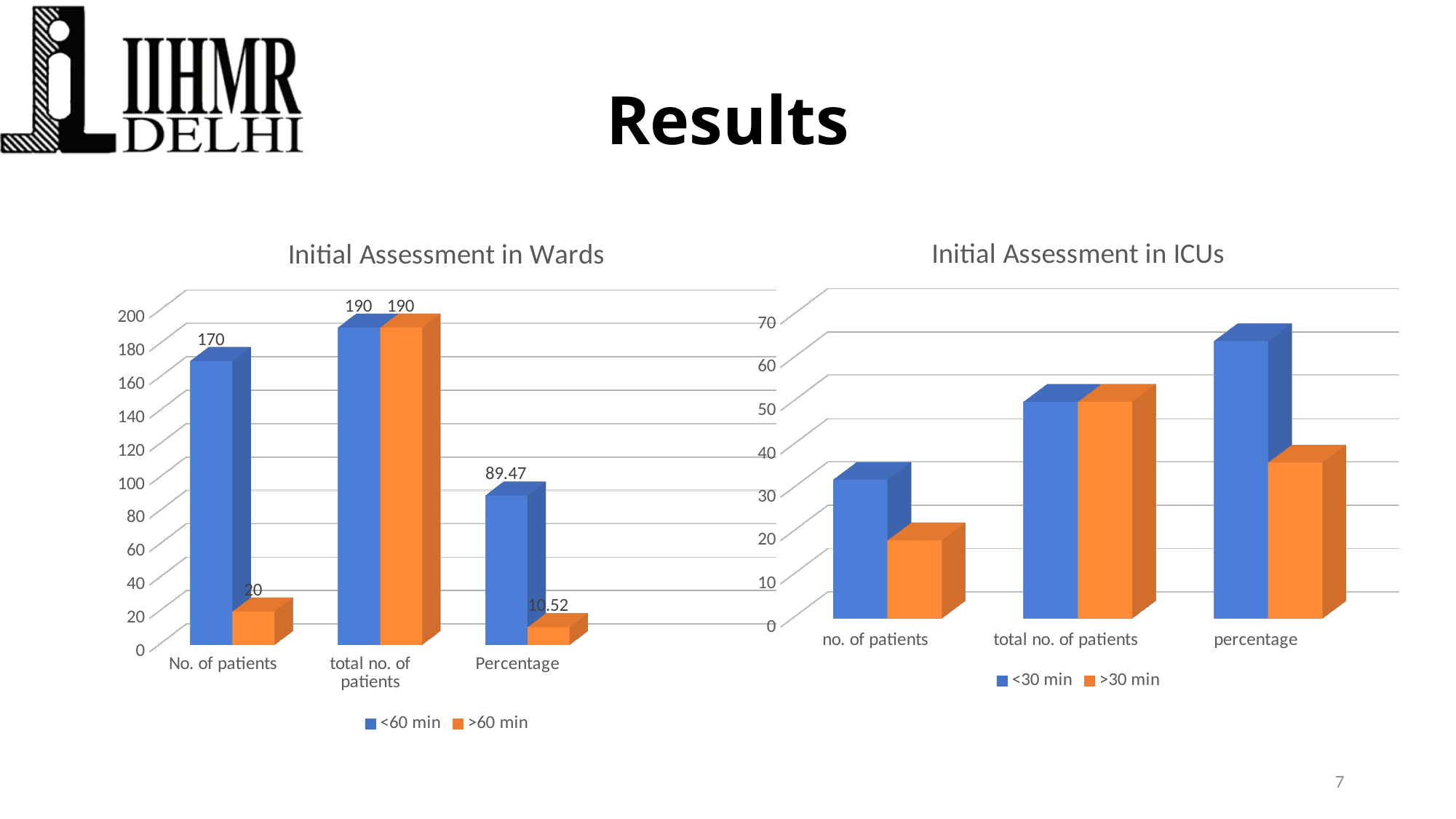
In the 'Initial Assessment in Wards' chart, which category has the lowest '>60 min' value? Percentage In the 'Initial Assessment in Wards' chart, what is the difference between the '<60 min' and '>60 min' values for 'No. of patients'? 150 In the 'Initial Assessment in ICUs' chart, is the '>30 min' value for 'no. of patients' greater or less than 30? less In the 'Initial Assessment in ICUs' chart, is the '<30 min' value for 'percentage' greater or less than 50? greater How many series does the legend of the 'Initial Assessment in ICUs' chart list? 2 In the 'Initial Assessment in Wards' chart, what is the value for '>60 min' in the 'Percentage' category? 10.52 In the 'Initial Assessment in ICUs' chart, which is larger for 'percentage': '<30 min' or '>30 min'? <30 min How many categories are shown on the x axis of the 'Initial Assessment in Wards' chart? 3 In the 'Initial Assessment in Wards' chart, what is the value for '<60 min' in the 'No. of patients' category? 170 What kind of chart is the 'Initial Assessment in ICUs' chart? Bar chart In the 'Initial Assessment in Wards' chart, which is larger for 'No. of patients': '<60 min' or '>60 min'? <60 min In the 'Initial Assessment in Wards' chart, what is the value for '<60 min' in the 'Percentage' category? 89.47